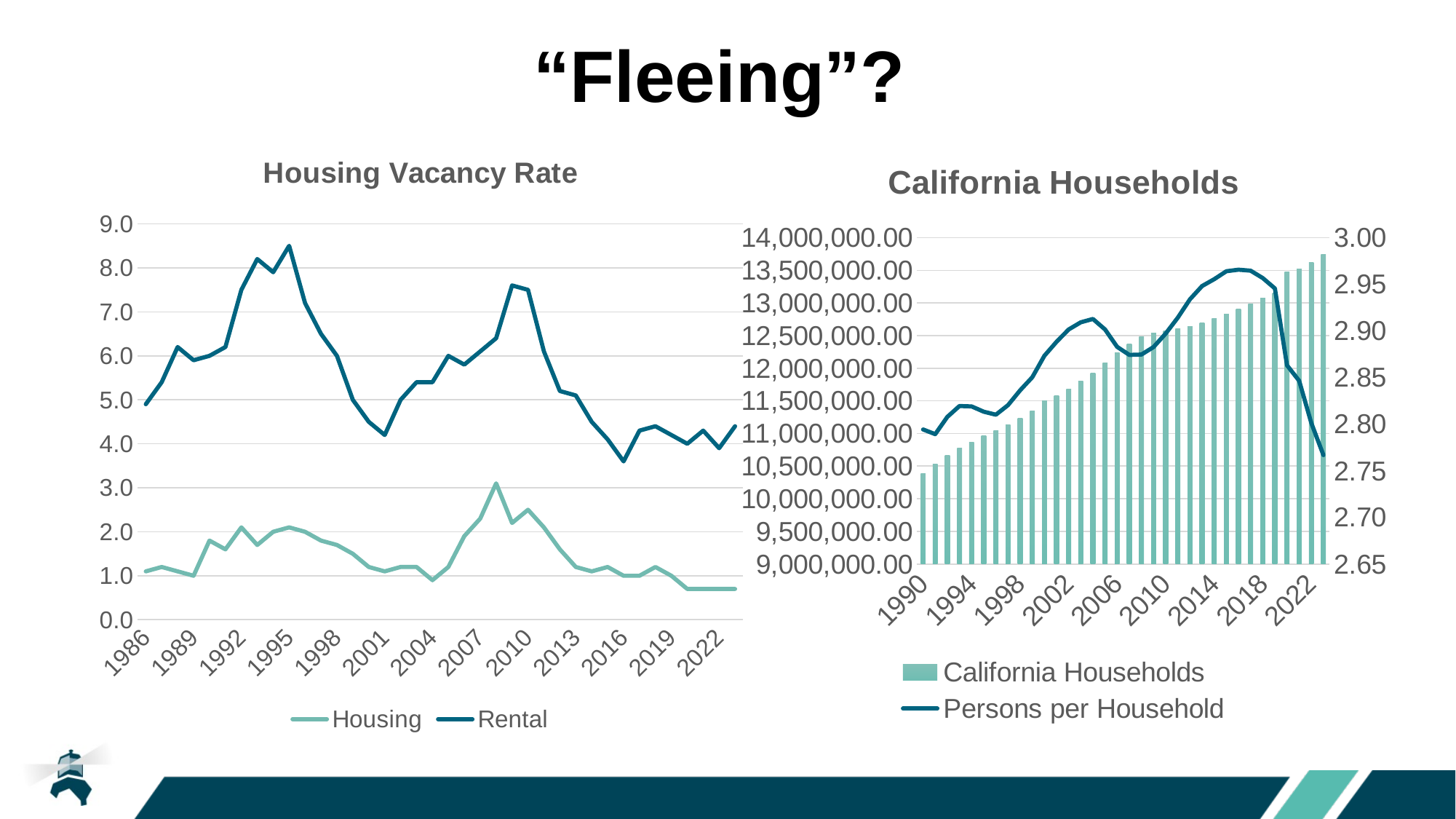
On the California Households chart, do the California Households bars rise or fall from 1990 to 2022? rise On the Housing Vacancy Rate chart, does the Rental series rise or fall between 2010 and 2016? fall On the Housing Vacancy Rate chart, is the Rental value for 1995 greater or less than 8.0? greater On the Housing Vacancy Rate chart, how many series does the legend list? 2 On the Housing Vacancy Rate chart, what kind of chart is it? line chart On the Housing Vacancy Rate chart, which series has the higher values, Housing or Rental? Rental On the Housing Vacancy Rate chart, is the Rental value for 1986 greater or less than 6.0? less On the California Households chart, how many series does the legend list? 2 On the Housing Vacancy Rate chart, is the Housing value for 2022 greater or less than 1.0? less On the California Households chart, which series is drawn as a line? Persons per Household